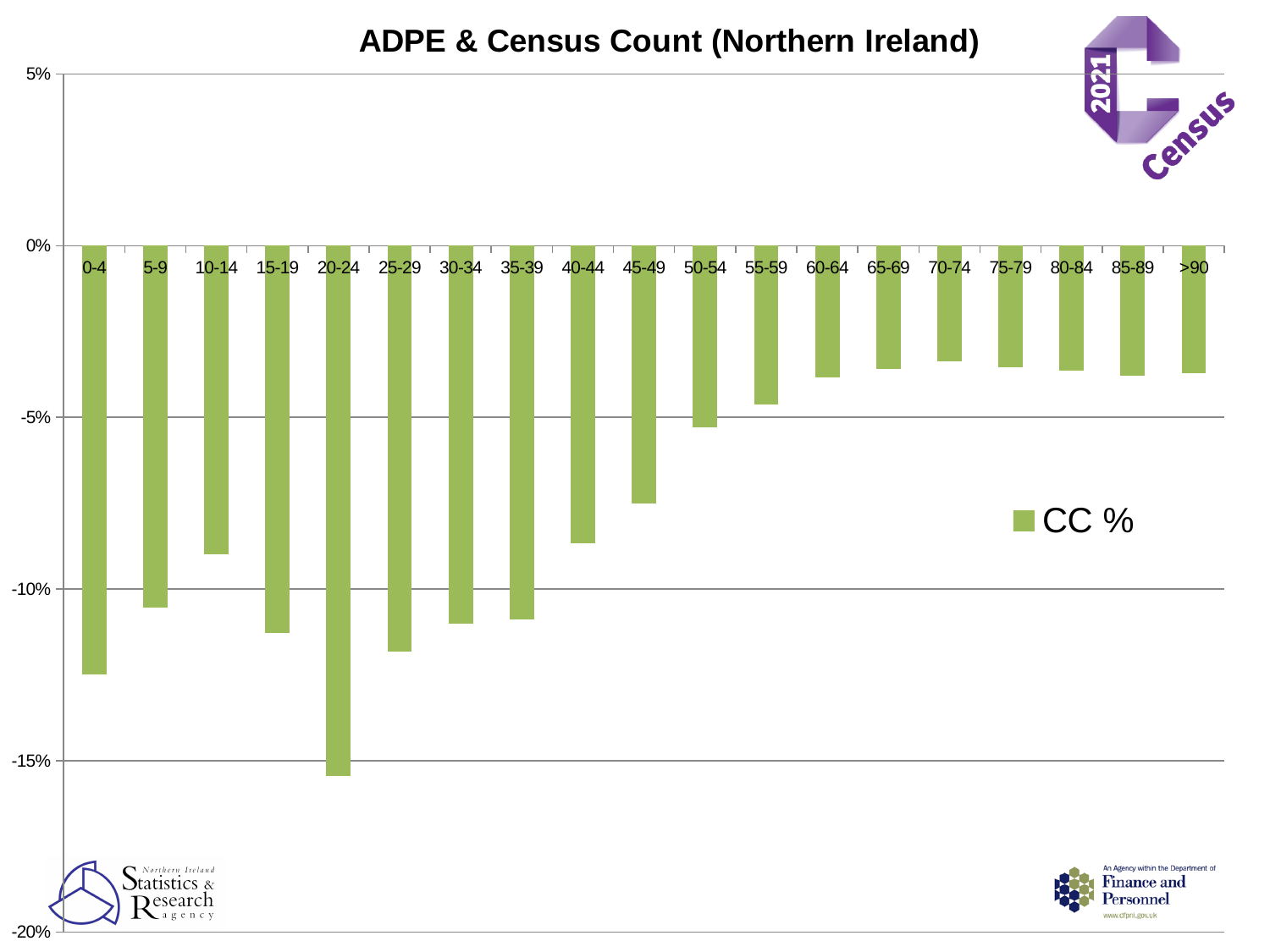
What is the title of the chart? ADPE & Census Count (Northern Ireland) Is the value for 55-59 greater or less than -5%? greater What is the name of the series shown in the legend? CC % What kind of chart is shown on the slide? bar chart Which has the lower value, 0-4 or 5-9? 0-4 Is the value for 0-4 greater or less than -10%? less Which age group has the lowest (most negative) value? 20-24 How many series does the legend list? 1 Is the value for 20-24 greater or less than -15%? less How many age-group categories are plotted on the x axis? 19 Moving from 20-24 to 70-74 along the x axis, do the values rise or fall? rise